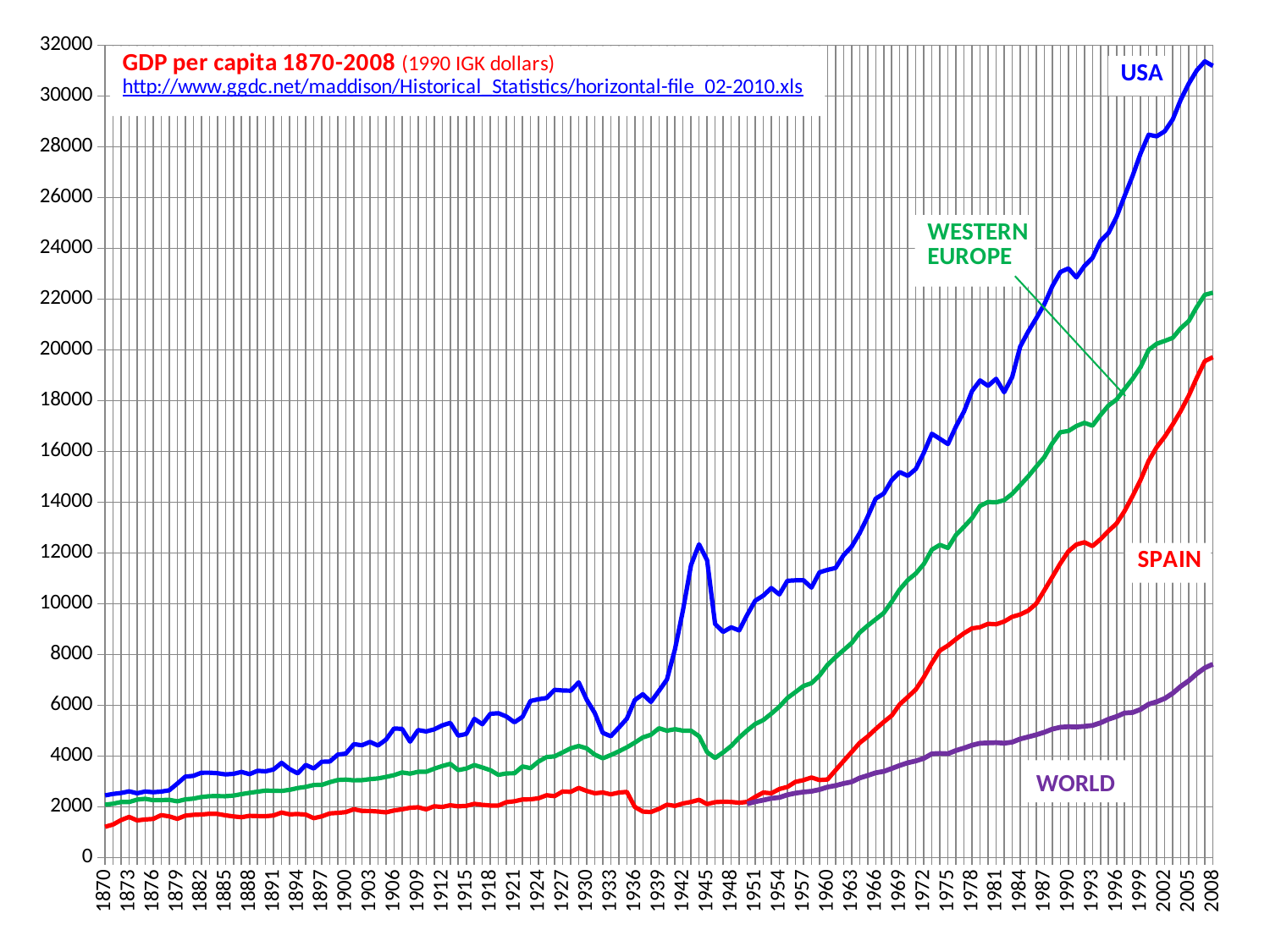
Does the USA series generally rise or fall from 1870 to 2008? rise What colour is the USA line? blue Which is larger in 2008, the value for USA or the value for SPAIN? USA How many series are plotted on the chart? 4 Is the value for USA in 2008 greater or less than 30000? greater What is the title of the chart? GDP per capita 1870-2008 Is the value for WESTERN EUROPE in 2008 greater or less than 20000? greater Is the value for SPAIN in 1870 greater or less than 2000? less Which series has the highest GDP per capita in 2008? USA What kind of chart is shown on the slide? line chart Which series has the lowest GDP per capita in 2008? WORLD